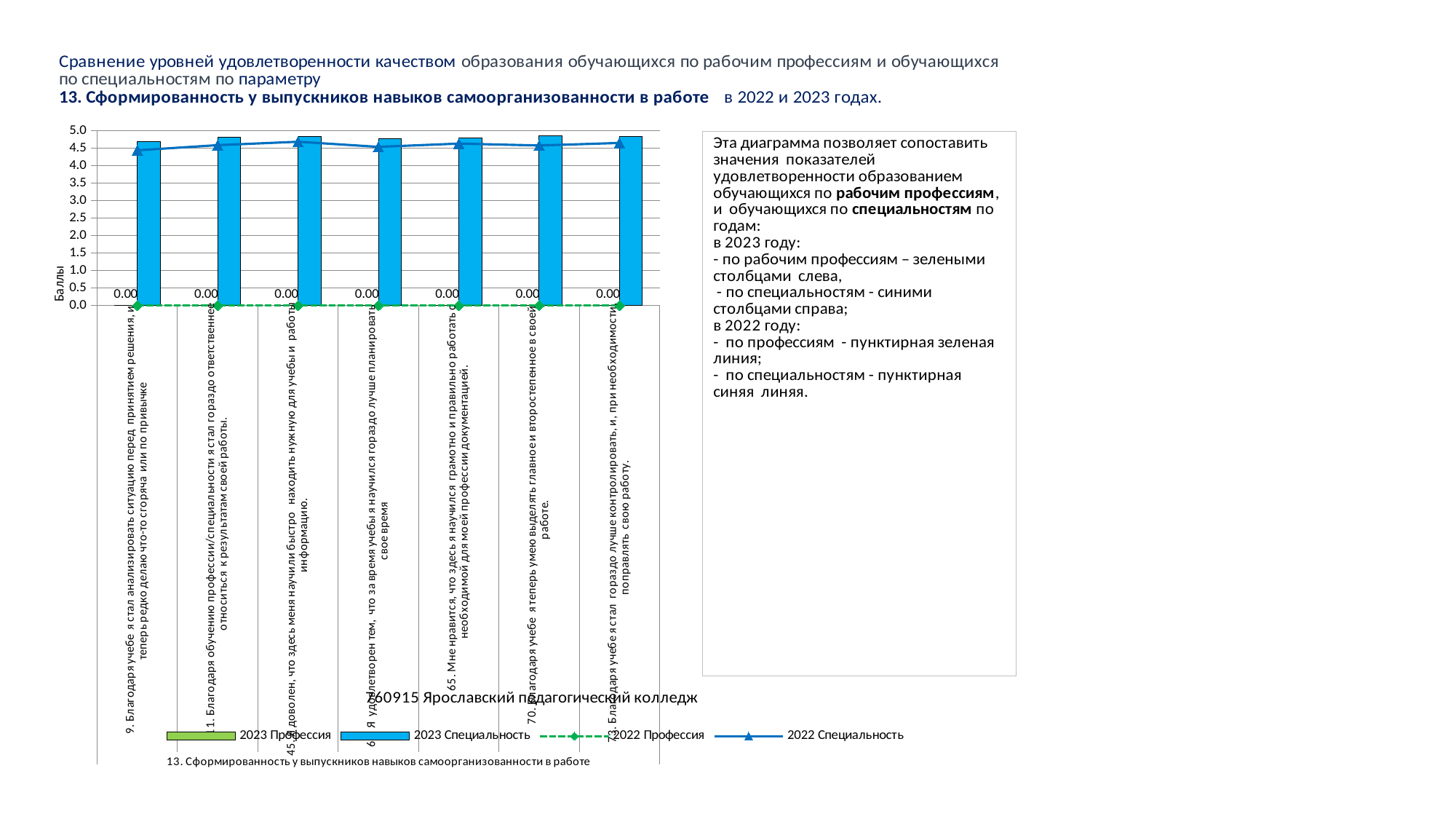
How many series does the chart legend list? 4 Is the value of the 2022 Профессия series for category 11 greater or less than 1.0? less What kind of chart is shown on the slide? bar chart with line series Is the value of the 2023 Специальность series for category 70 (Благодаря учебе я теперь умею выделять главное и второстепенное в своей работе) greater or less than 4.5? greater What is the value of the 2023 Профессия series for category 9 (Благодаря учебе я стал анализировать ситуацию перед принятием решения)? 0.00 What is the label of the vertical axis of the chart? Баллы What is the value of the 2023 Профессия series for category 65 (Мне нравится, что здесь я научился грамотно и правильно работать с документацией)? 0.00 Is the value of the 2023 Специальность series for category 9 greater or less than 4.0? greater What colour are the bars of the 2023 Специальность series? blue For category 65, which is larger: the 2023 Специальность value or the 2023 Профессия value? 2023 Специальность How many categories are plotted along the x axis of the chart? 7